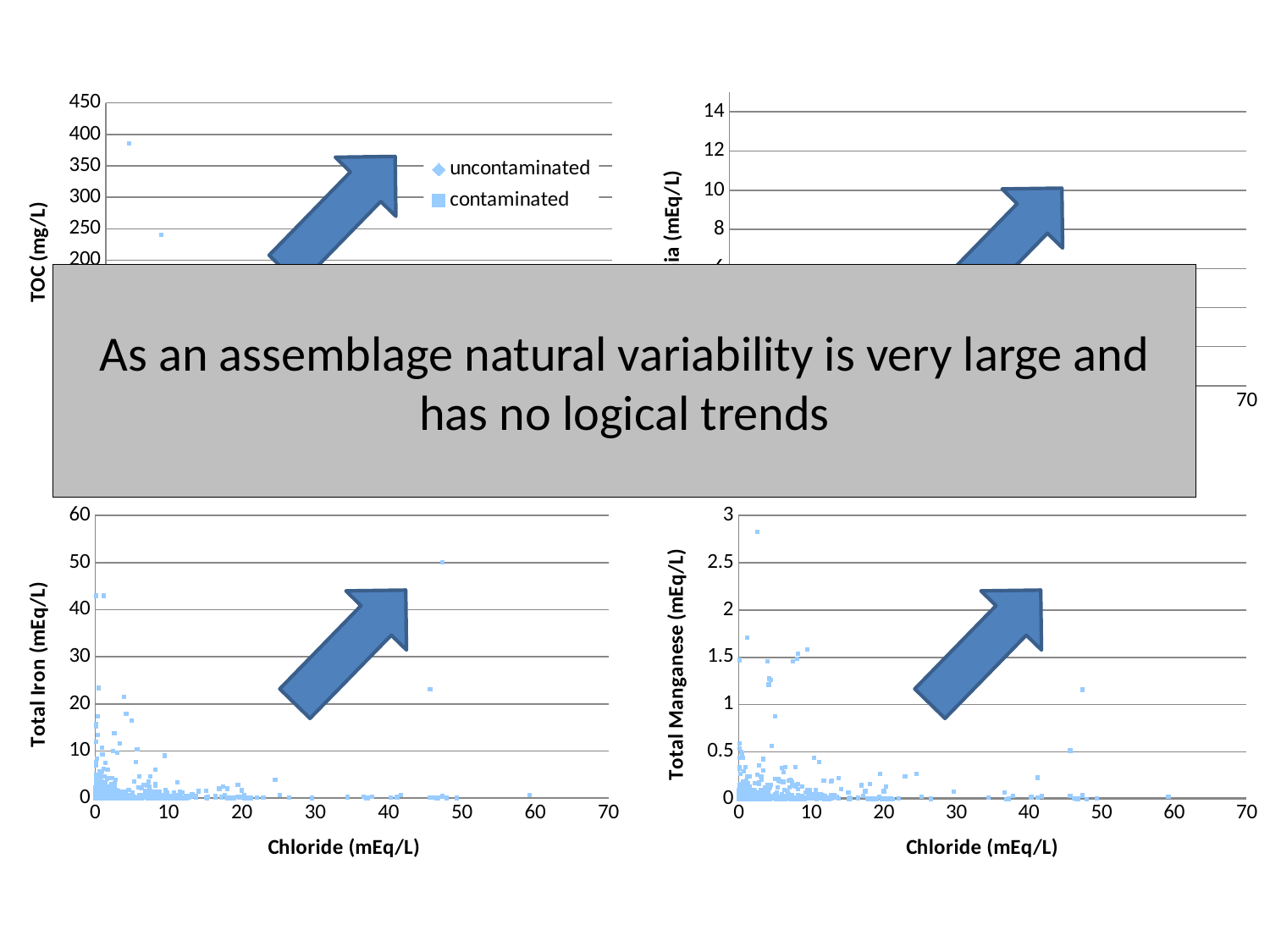
What are the two series named in the legend of the top-left chart (TOC vs Chloride)? uncontaminated and contaminated In the bottom-left chart (Total Iron vs Chloride), is the highest plotted Total Iron value greater or less than 40? greater How many charts are shown on the slide? 4 In the top-left chart (TOC vs Chloride), is the highest plotted TOC value greater or less than 350? greater What kind of chart is the bottom-left chart (Total Iron vs Chloride)? scatter chart How many series does the legend of the top-left chart (TOC vs Chloride) list? 2 What is the highest tick value on the x-axis of the bottom-left chart (Total Iron vs Chloride)? 70 What is the x-axis label of the bottom-right chart (Total Manganese)? Chloride (mEq/L) What is the highest tick value on the y-axis of the bottom-right chart (Total Manganese)? 3 In the bottom-right chart (Total Manganese vs Chloride), is the highest plotted Total Manganese value greater or less than 2.5? greater What is the highest tick value on the y-axis of the top-left chart (TOC)? 450 What is the highest tick value on the y-axis of the bottom-left chart (Total Iron)? 60